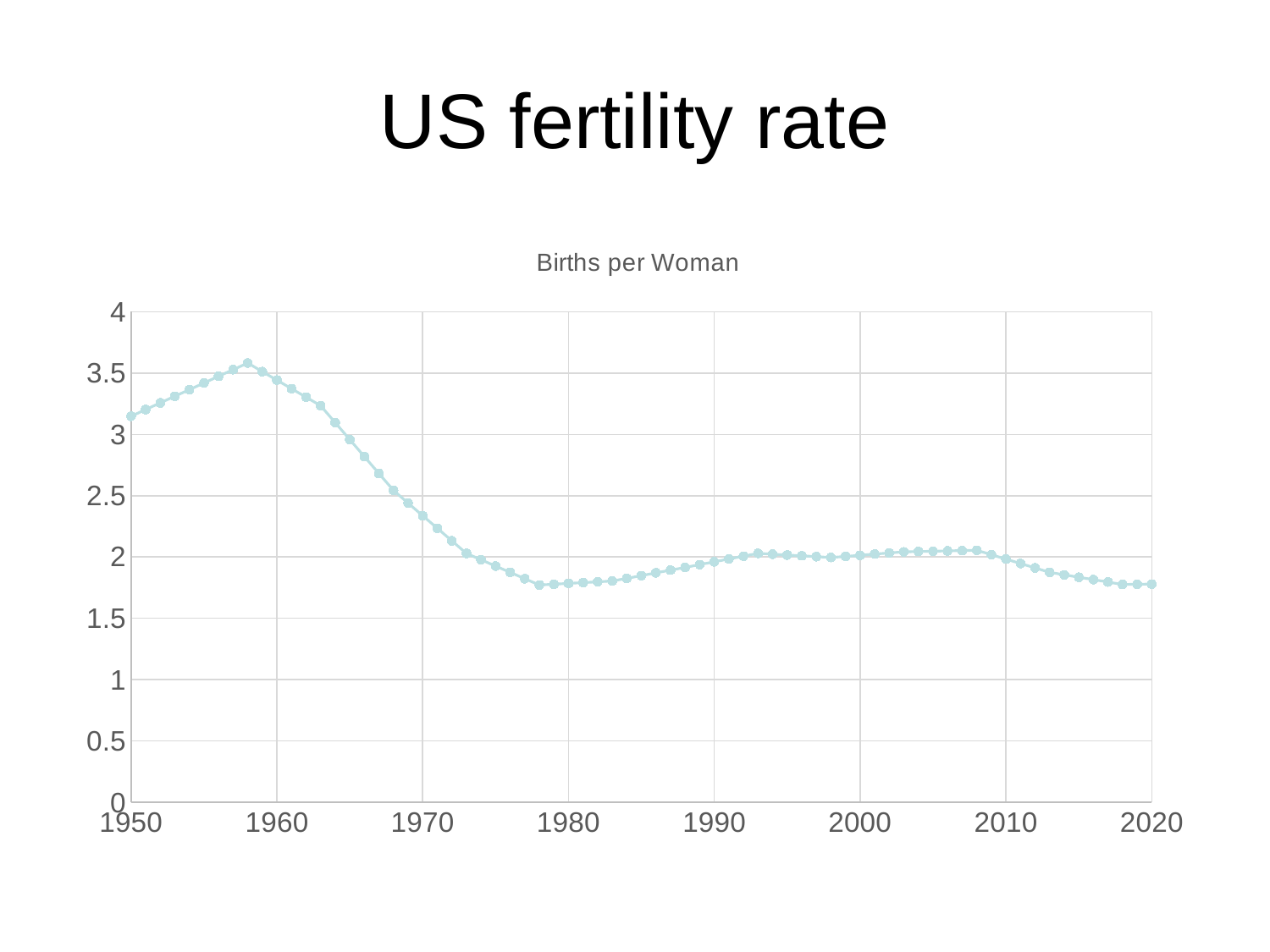
Is the value for 1980 greater or less than 2? less Is the value for 1970 greater or less than 2? greater What kind of chart is shown on the slide? line chart Is the value for 2020 greater or less than 2? less Which is larger, the value for 1950 or the value for 2020? 1950 Which is larger, the value for 1960 or the value for 1970? 1960 Does the highest point on the line occur before or after 1960? before Do the values rise or fall between 1960 and 1980? fall What is the title of the chart? Births per Woman